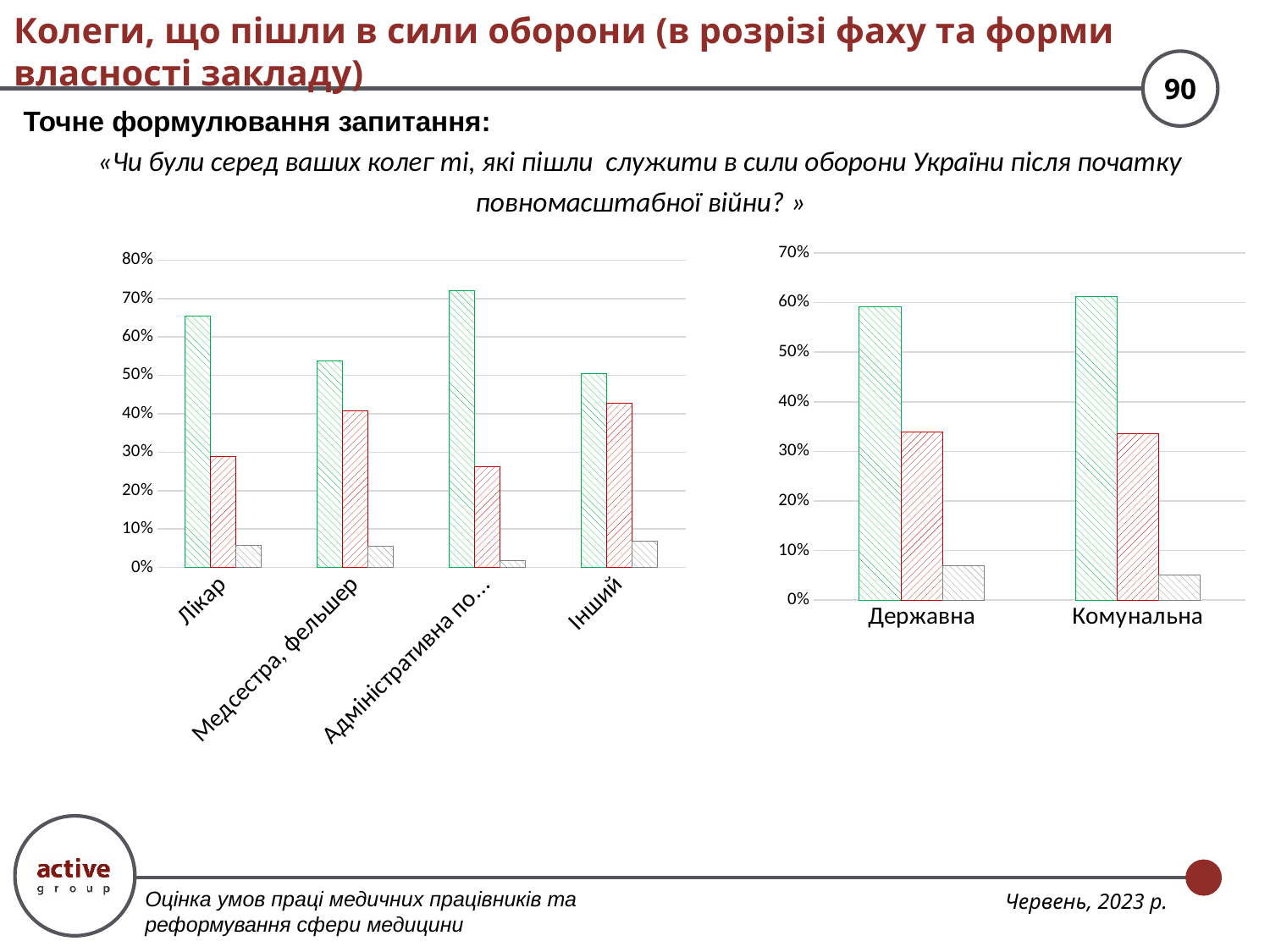
How many bars are shown for each category in the right chart? 3 In the left chart, is the red bar for Лікар greater or less than 20%? greater How many categories are shown on the x axis of the left chart? 4 How many categories are shown on the x axis of the right chart? 2 In the left chart, is the green bar for Лікар greater or less than 60%? greater In the left chart, which is larger: the green bar for Лікар or the green bar for Медсестра, фельшер? Лікар In the right chart, which is larger: the grey bar for Державна or the grey bar for Комунальна? Державна In the left chart, is the grey bar for Інший greater or less than 10%? less What kind of chart is the left chart (by profession)? bar chart